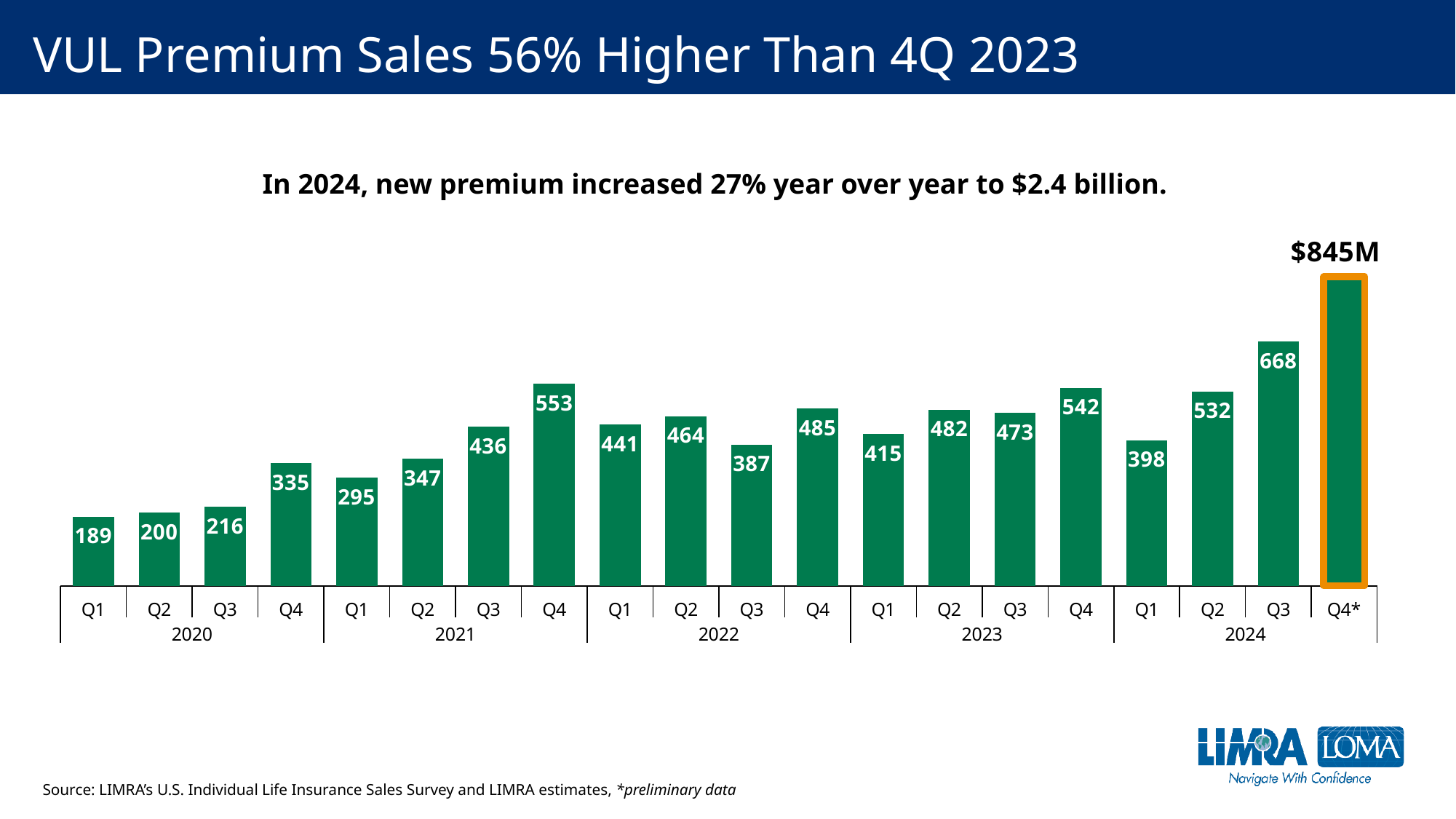
What kind of chart is shown on the slide? Bar chart Which quarter has the highest value? Q4* 2024 What is the value for Q4 2021? 553 What is the value for Q3 2024? 668 Do the values generally rise or fall from Q1 2020 to Q4 2024? Rise Which is larger, Q4 2023 or Q4 2022? Q4 2023 What is the difference between Q3 2024 and Q2 2024? 136 Which quarter has the lowest value? Q1 2020 What is the value for Q4 2024 (Q4*)? $845M What is the value for Q1 2020? 189 Which bar is highlighted with an orange outline? Q4* 2024 How many quarterly bars are shown in the chart? 20